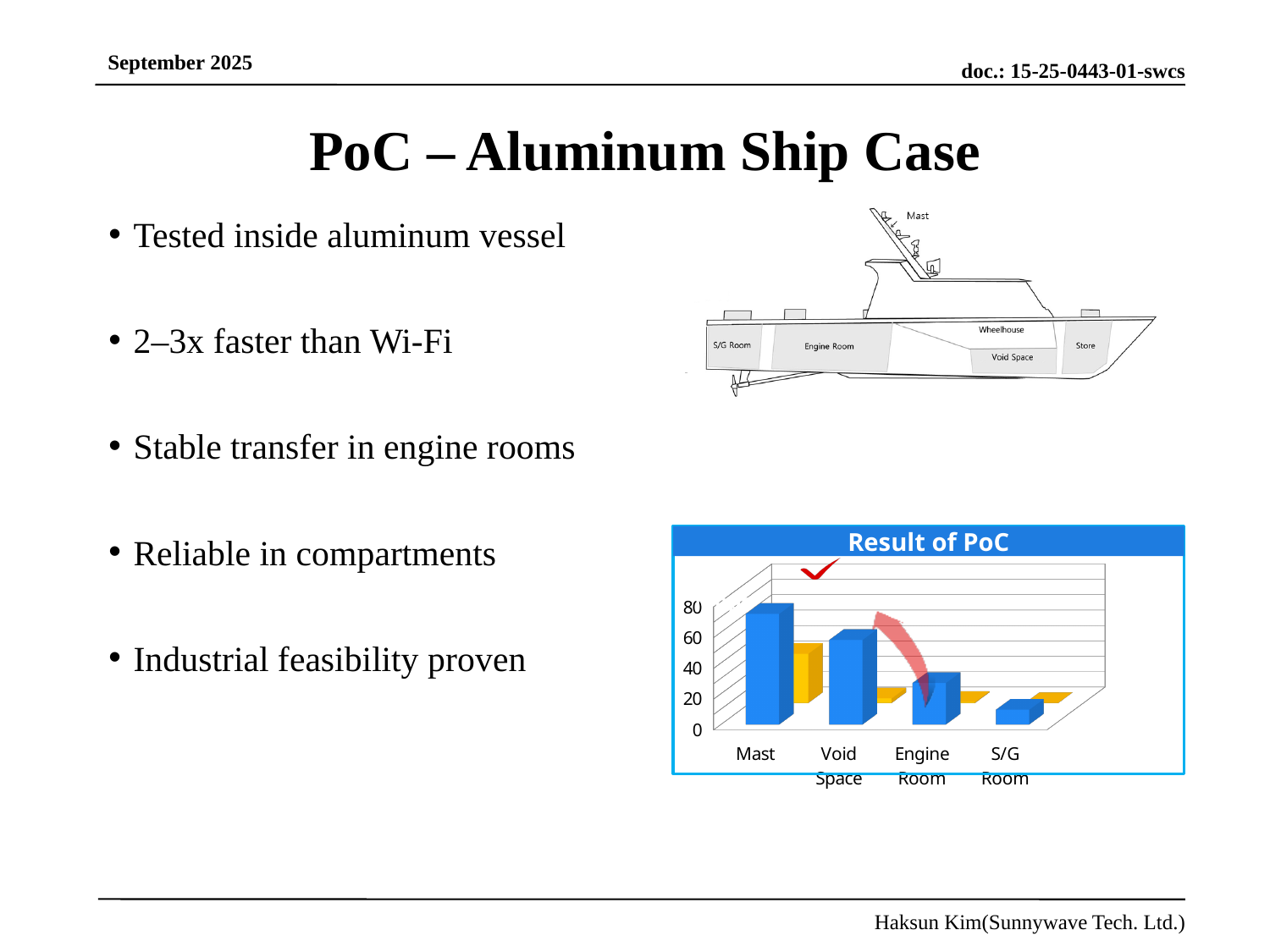
In the "Result of PoC" chart, is the blue bar for S/G Room greater or less than 20? less How many categories are shown on the x axis of the "Result of PoC" chart? 4 In the "Result of PoC" chart, which has the taller blue bar, Mast or S/G Room? Mast In the "Result of PoC" chart, which category has the shortest blue bar? S/G Room In the "Result of PoC" chart, do the blue bars rise or fall from Mast to S/G Room? fall What kind of chart is shown under the title "Result of PoC"? bar chart In the "Result of PoC" chart, is the blue bar for Mast greater or less than 60? greater In the "Result of PoC" chart, which has the taller blue bar, Void Space or Engine Room? Void Space In the "Result of PoC" chart, is the blue bar for Engine Room greater or less than 60? less What is the title of the chart on the slide? Result of PoC In the "Result of PoC" chart, which category has the tallest blue bar? Mast